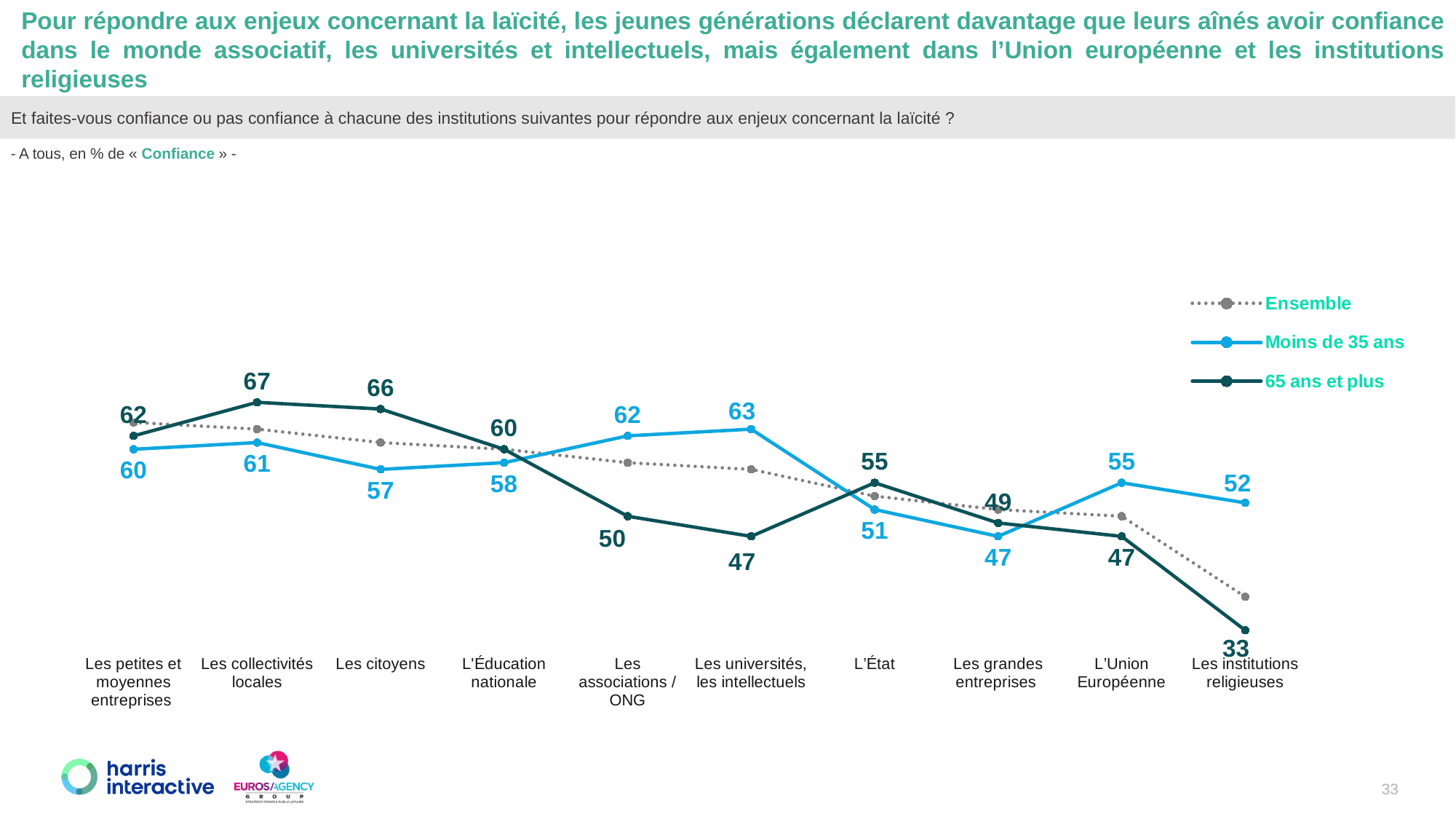
What is the value for '65 ans et plus' for 'Les institutions religieuses'? 33 For which institution is the '65 ans et plus' value lowest? Les institutions religieuses What is the value for '65 ans et plus' for 'L'Union Européenne'? 47 How many institutions are shown along the x axis? 10 Which series is drawn as a grey dotted line? Ensemble For 'Les institutions religieuses', what is the difference between the 'Moins de 35 ans' value and the '65 ans et plus' value? 19 For which institution is the 'Moins de 35 ans' value highest? Les universités, les intellectuels What is the value for 'Moins de 35 ans' for 'Les universités, les intellectuels'? 63 For 'Les collectivités locales', which series has the larger value, 'Moins de 35 ans' or '65 ans et plus'? 65 ans et plus For which institution is the '65 ans et plus' value highest? Les collectivités locales How many series does the legend list? 3 What kind of chart is shown on the slide? line chart